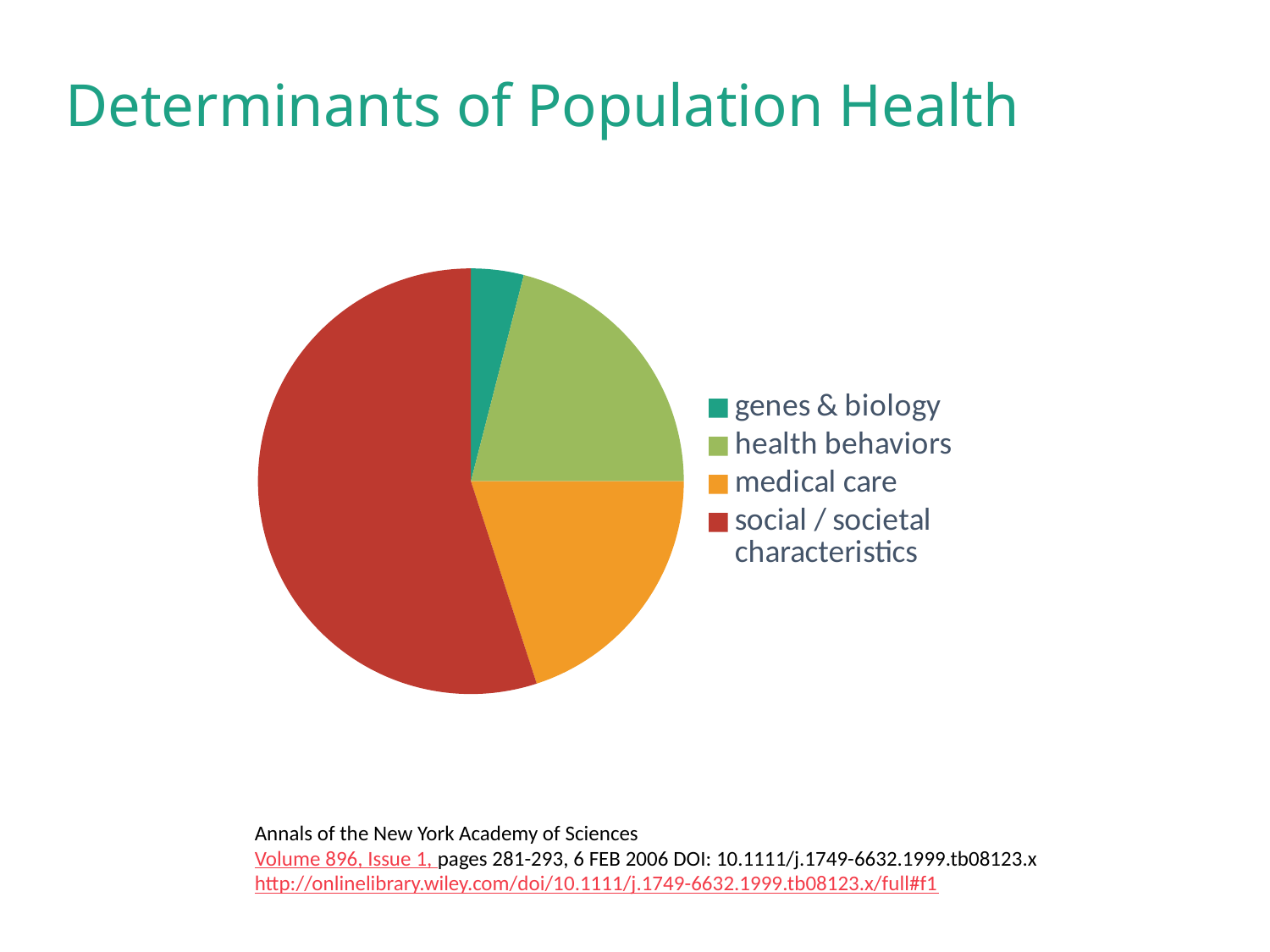
How many slices does the pie chart have? 4 How many categories does the pie chart's legend list? 4 Which slice is larger: genes & biology or social / societal characteristics? social / societal characteristics What is the title of the slide containing the pie chart? Determinants of Population Health Which category has the smallest slice of the pie chart? genes & biology What kind of chart is shown on the slide? pie chart Which colour represents the medical care slice in the pie chart? orange Which slice is larger: genes & biology or health behaviors? health behaviors Which slice is larger: social / societal characteristics or medical care? social / societal characteristics Which category has the largest slice of the pie chart? social / societal characteristics